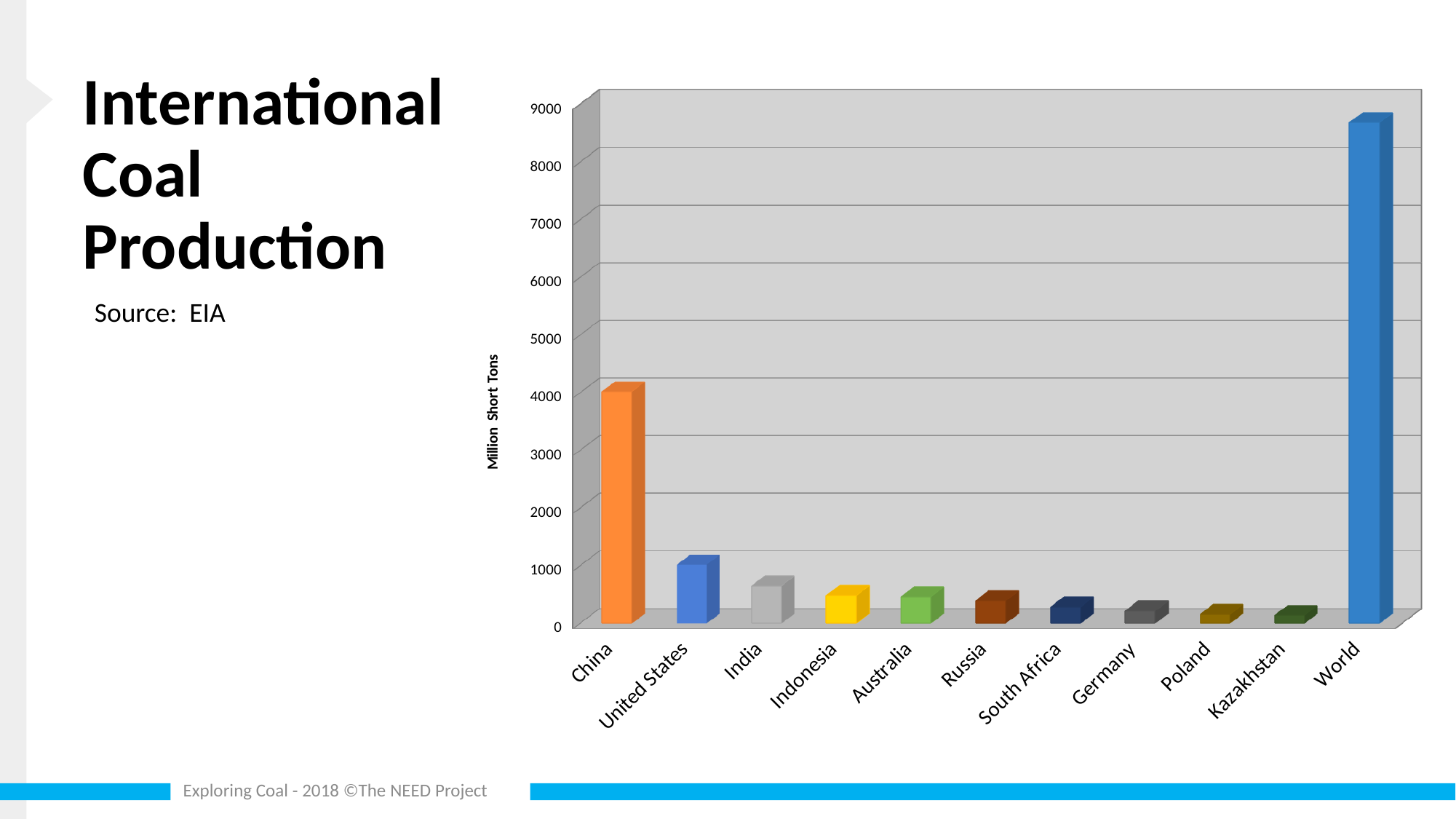
Is the value for India greater or less than 1000? less Which has the larger value, India or Germany? India What is the title of the chart on the slide? International Coal Production Is the value for World greater or less than 8000? greater Is the value for United States greater or less than 2000? less Which has the larger value, China or United States? China What kind of chart is shown on the slide? bar chart What is the label on the vertical axis of the chart? Million Short Tons Which category has the highest bar in the chart? World How many categories are shown on the x axis of the chart? 11